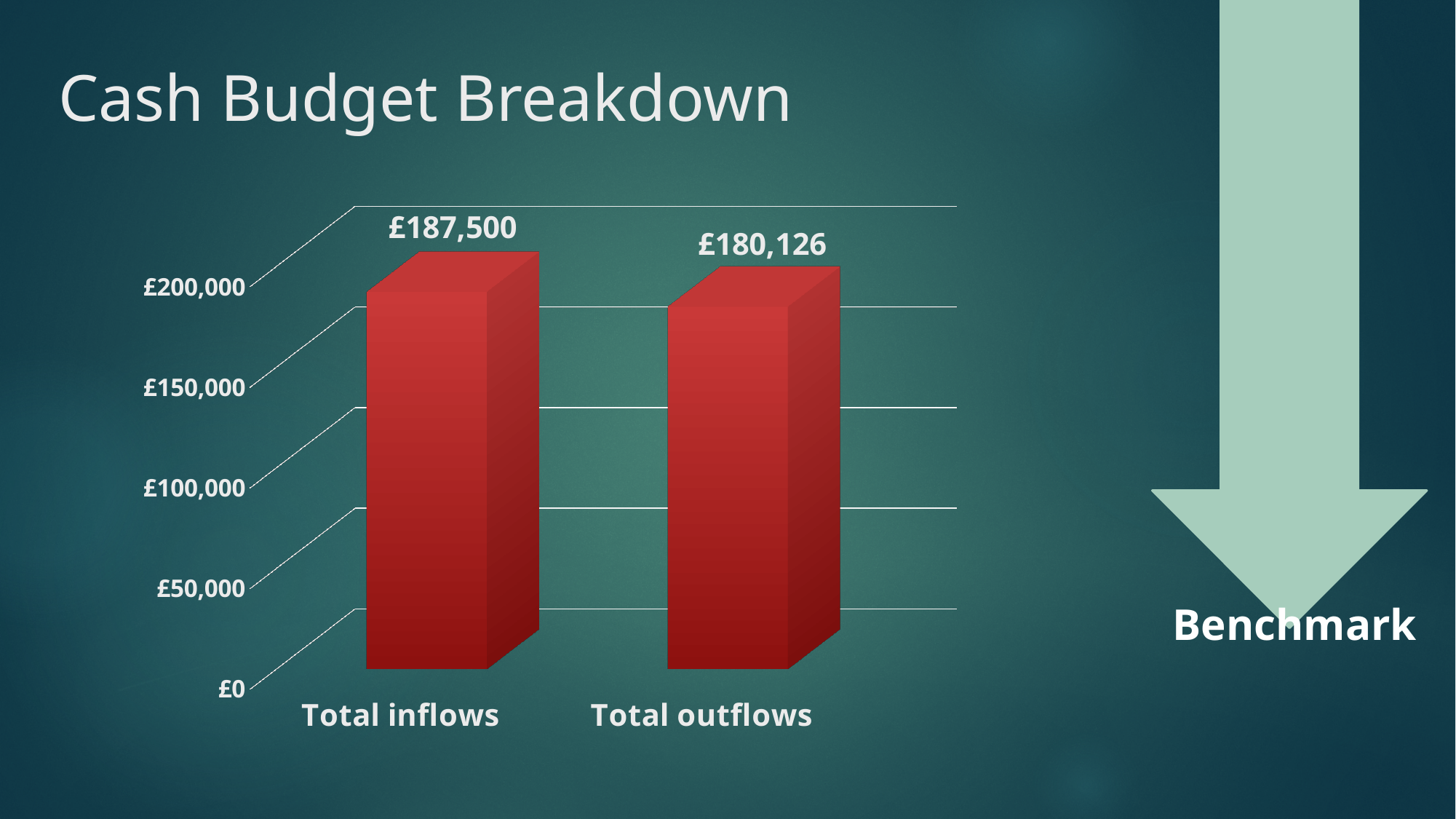
Which category has the lowest value? Total outflows What is the value for Total outflows? £180,126 What is the difference between Total inflows and Total outflows? £7,374 What colour are the bars in the chart? Red Which category has the highest value? Total inflows Is the value for Total outflows greater or less than £150,000? greater Which is larger, Total inflows or Total outflows? Total inflows What kind of chart is shown on the slide? Bar chart How many categories are shown on the chart? 2 What is the value for Total inflows? £187,500 What is the title of the slide containing the chart? Cash Budget Breakdown Is the value for Total inflows greater or less than £200,000? less